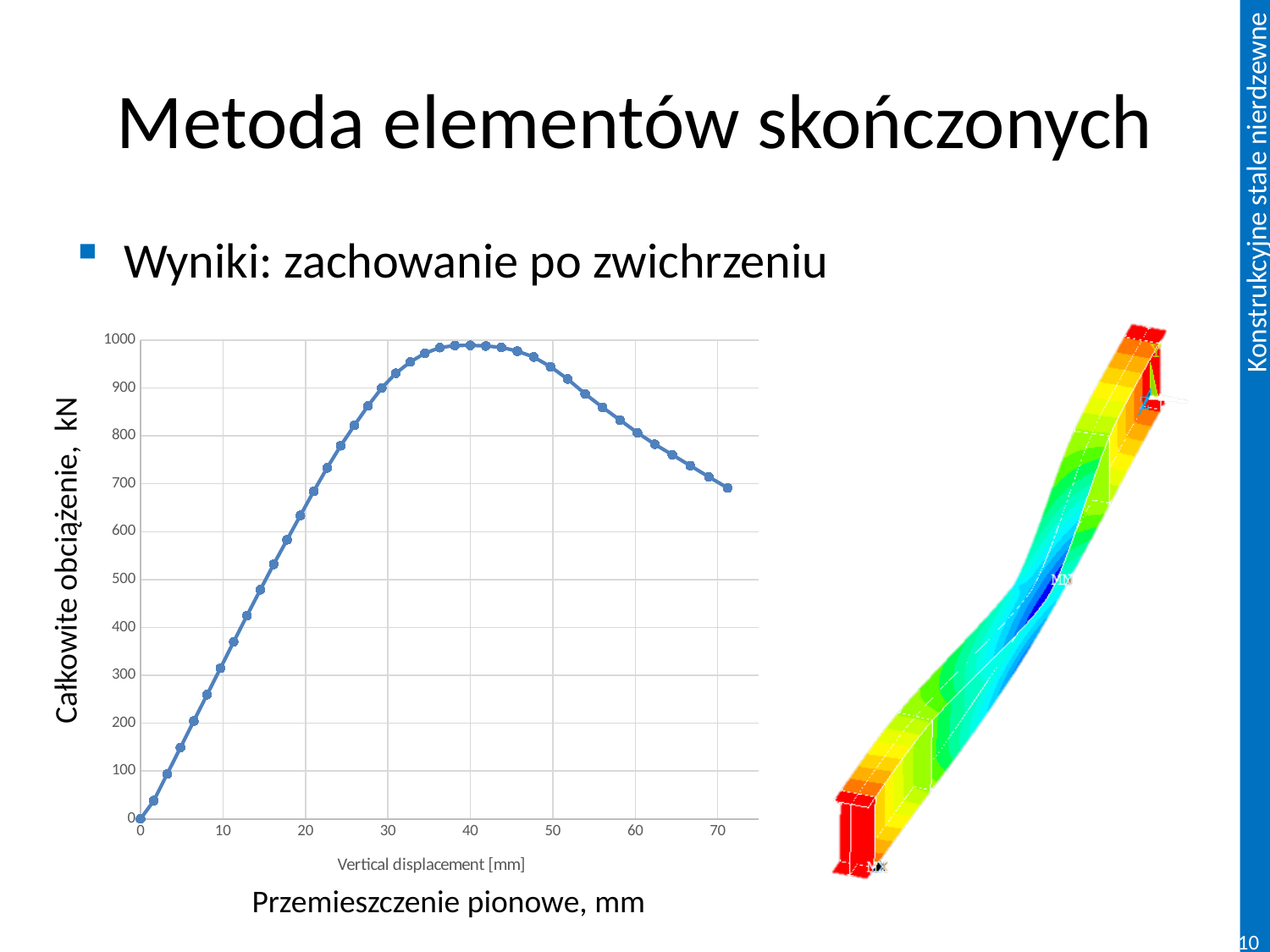
Is the peak load on the curve greater or less than 900 kN? greater Is the load at a vertical displacement of 70 mm greater or less than 800 kN? less Is the load at a vertical displacement of 10 mm greater or less than 400 kN? less What is the load value at a vertical displacement of 0 mm? 0 What kind of chart is shown on the slide? line chart How does the load change as vertical displacement increases from 0 to 70 mm? rises to a peak around 40 mm, then falls Which is larger: the load at 40 mm displacement or the load at 70 mm displacement? 40 mm What axis title is printed below the horizontal axis inside the chart? Vertical displacement [mm] What is the label on the vertical axis of the chart? Całkowite obciążenie, kN Which is larger: the load at 10 mm displacement or the load at 70 mm displacement? 70 mm